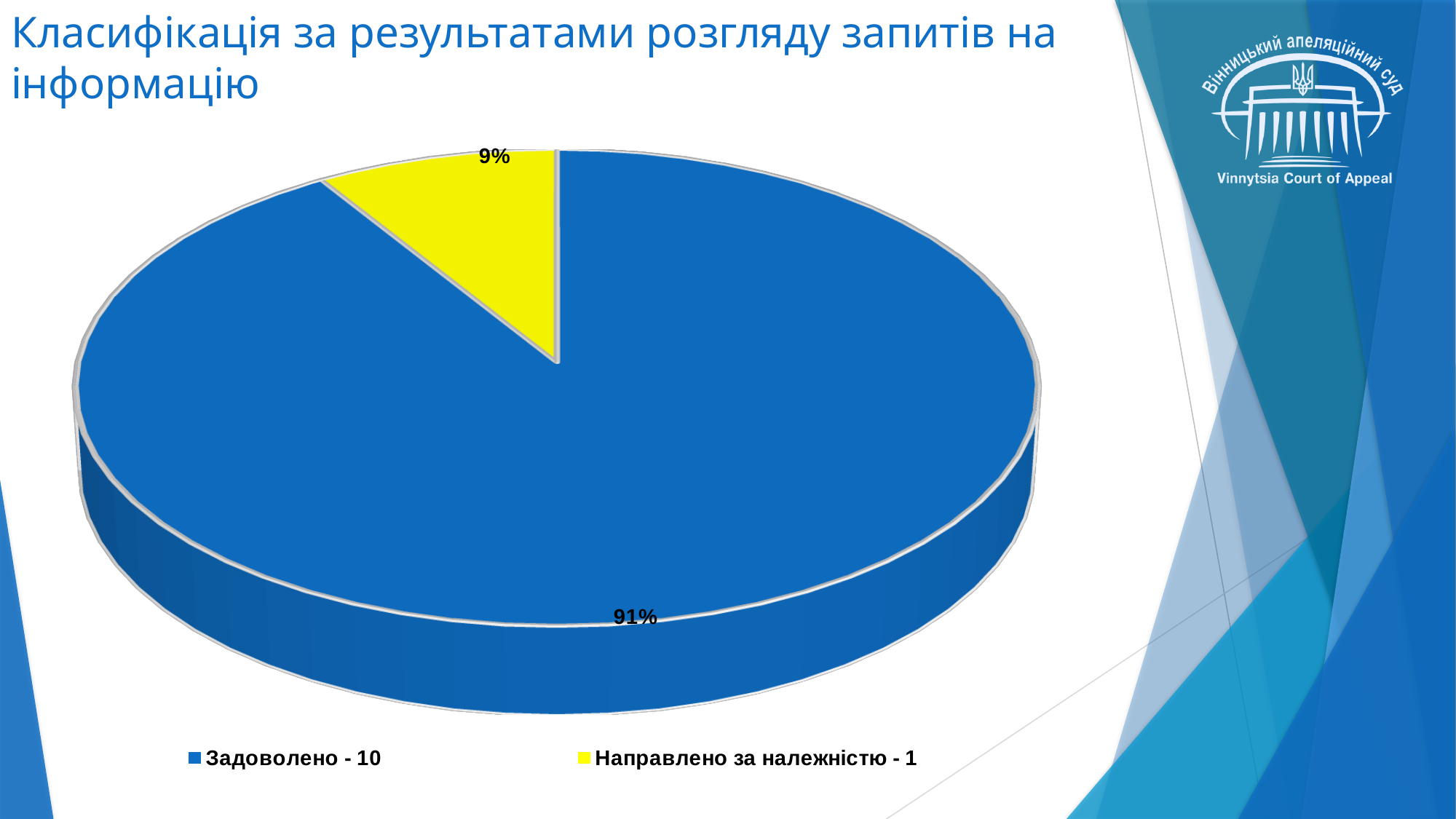
How many slices does the pie chart have? 2 What percentage share does the "Задоволено - 10" slice have? 91% What is the difference in percentage points between the "Задоволено - 10" slice and the "Направлено за належністю - 1" slice? 82 percentage points What colour is the "Направлено за належністю - 1" slice? Yellow What is the title of the chart slide? Класифікація за результатами розгляду запитів на інформацію Which category has the smallest slice of the pie? Направлено за належністю - 1 Which slice is larger: "Задоволено - 10" or "Направлено за належністю - 1"? Задоволено - 10 How many entries does the legend list? 2 What kind of chart is shown on the slide? Pie chart What percentage share does the "Направлено за належністю - 1" slice have? 9% Which category has the largest slice of the pie? Задоволено - 10